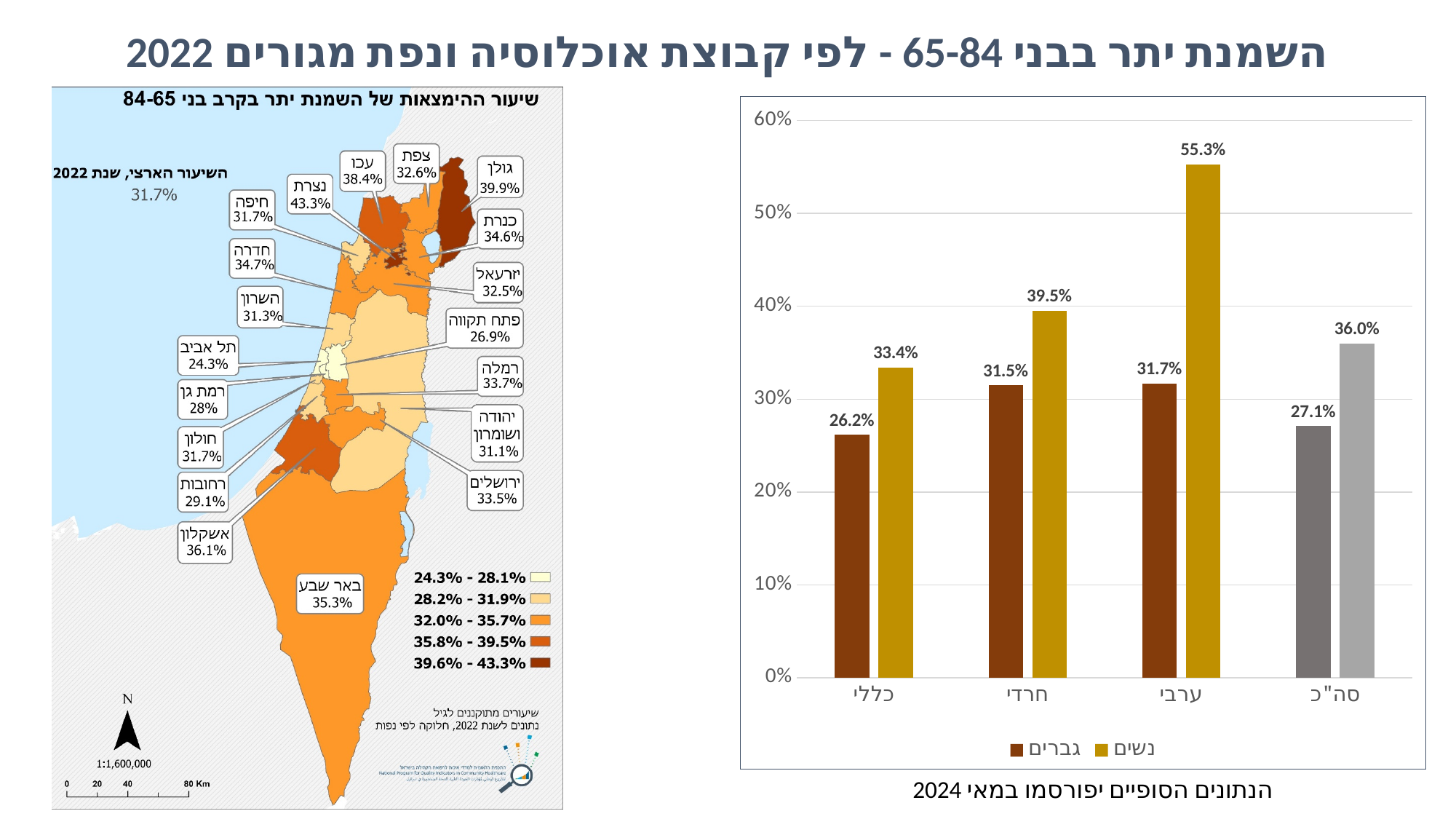
In the bar chart on the right, which is larger: the men's value for חרדי or the men's value for ערבי? ערבי In the bar chart on the right, what is the value for women (נשים) in the חרדי category? 39.5% In the bar chart on the right, what is the difference between the women's and men's values in the ערבי category? 23.6% In the bar chart on the right, which category has the lowest value for men (גברים)? כללי How many series does the legend of the bar chart on the right list? 2 What type of chart is shown on the right side of the slide? Bar chart In the bar chart on the right, what is the value for men (גברים) in the כללי category? 26.2% In the bar chart on the right, which category has the highest value for women (נשים)? ערבי In the bar chart on the right, what is the difference between the women's and men's values in the סה"כ category? 8.9% In the bar chart on the right, what is the value for men (גברים) in the סה"כ category? 27.1% In the bar chart on the right, what is the value for women (נשים) in the ערבי category? 55.3% How many categories are shown on the x axis of the bar chart on the right? 4